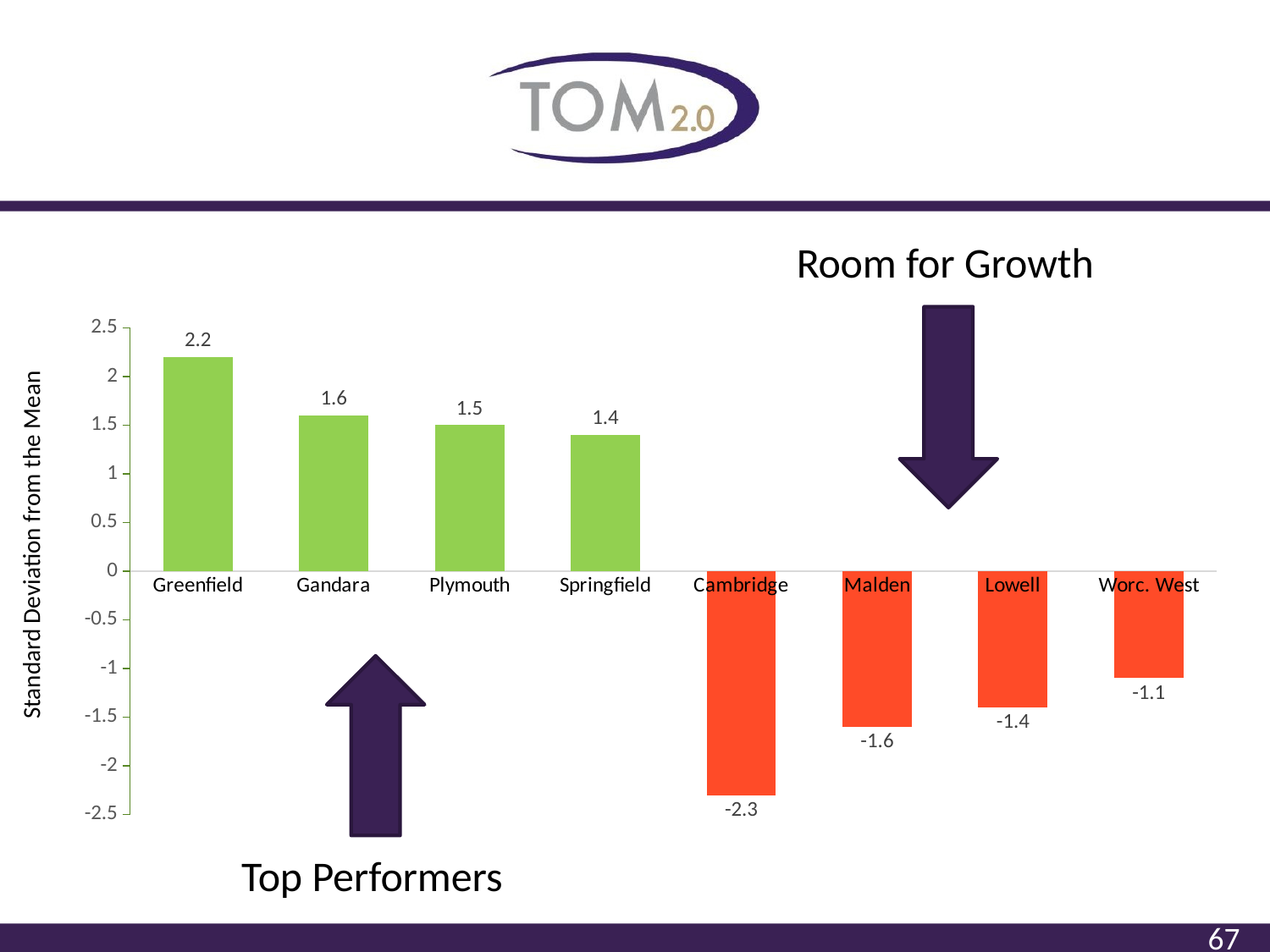
What kind of chart is shown on the slide? bar chart Which has the larger value, Gandara or Plymouth? Gandara What colour are the bars with negative values? red What is the value for Cambridge? -2.3 Which category has the highest value? Greenfield What is the difference between the values for Greenfield and Springfield? 0.8 Is the value for Malden greater or less than -1? less What is the value for Worc. West? -1.1 What is the label of the vertical axis? Standard Deviation from the Mean Which category has the lowest value? Cambridge What is the value for Greenfield? 2.2 How many categories are shown on the x axis? 8